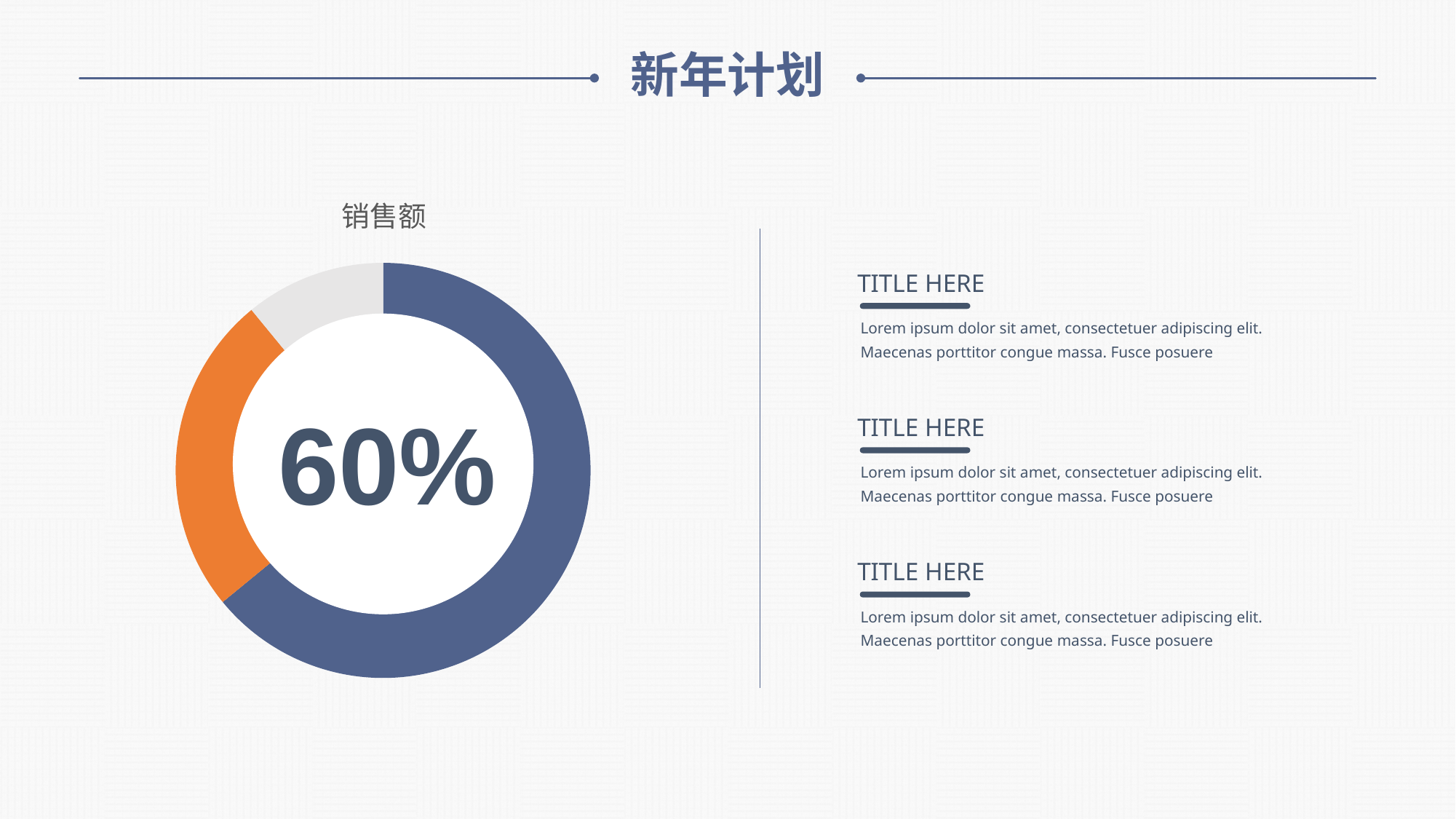
Which colour segment of the doughnut chart is the smallest? Grey Which colour segment of the doughnut chart is the largest? Blue Which segment is larger, the orange one or the grey one? Orange How many segments does the doughnut chart have? 3 What percentage value is printed in the centre of the doughnut chart? 60% Is the blue segment's share of the doughnut chart greater or less than 50%? greater What is the title of the chart? 销售额 What kind of chart is shown on the slide? Doughnut (pie) chart Which segment is larger, the blue one or the orange one? Blue Does the chart display a legend? No Is the grey segment's share of the doughnut chart greater or less than 25%? less